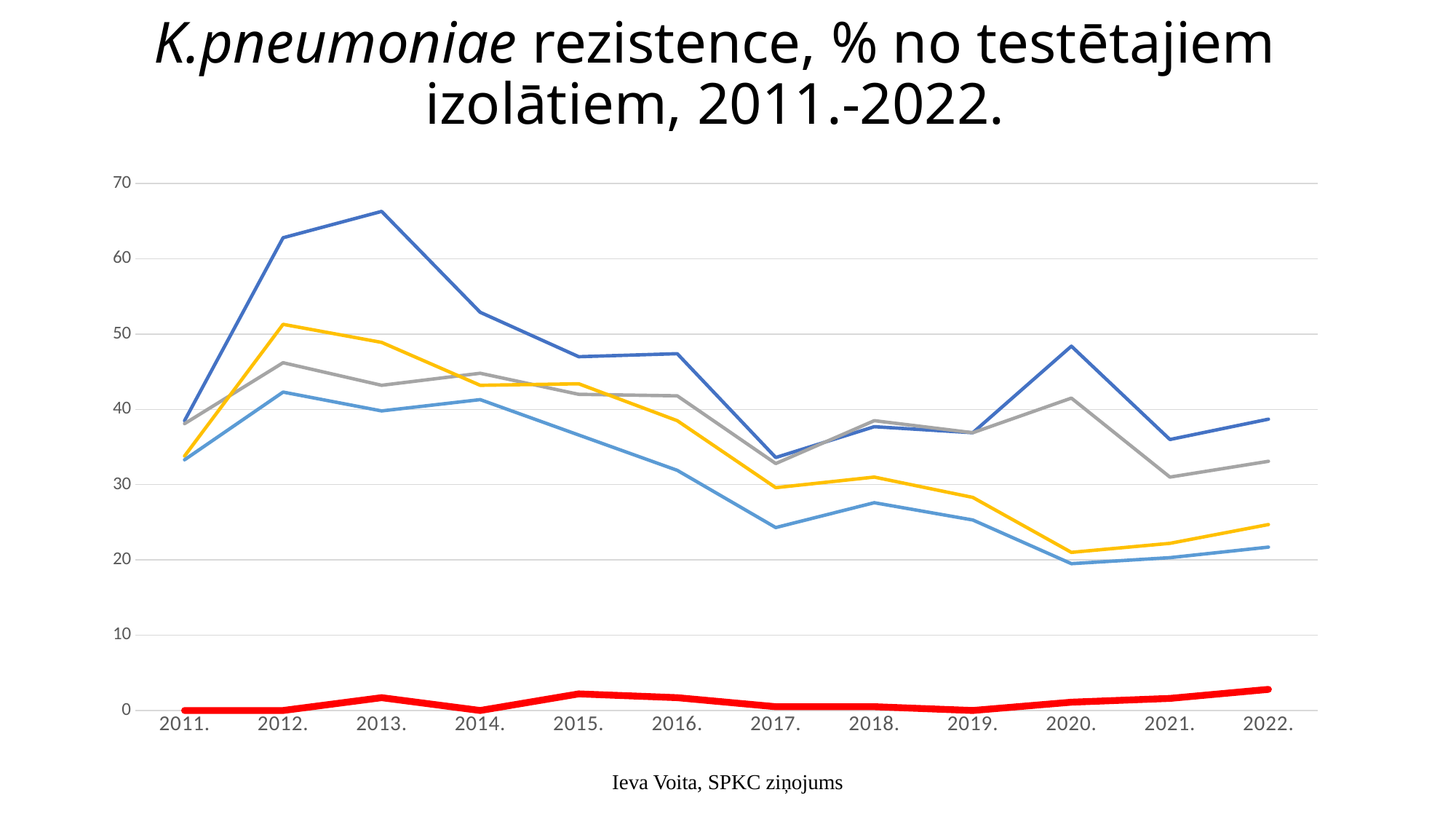
Is the value of the red line in 2022 greater or less than 10? less What is the title of the chart on the slide? K.pneumoniae rezistence, % no testētajiem izolātiem, 2011.-2022. In which year does the dark blue line reach its highest value? 2013. In which year does the yellow line reach its highest value? 2012. Is the value of the light blue line in 2017 greater or less than 30? less What kind of chart is shown on the slide? line chart Is the value of the grey line in 2021 greater or less than 40? less Does the dark blue line rise or fall between 2013 and 2017? fall How many lines are plotted on the chart? 5 How many years are shown on the x axis of the chart? 12 In 2022, which line has the higher value, the grey line or the yellow line? the grey line